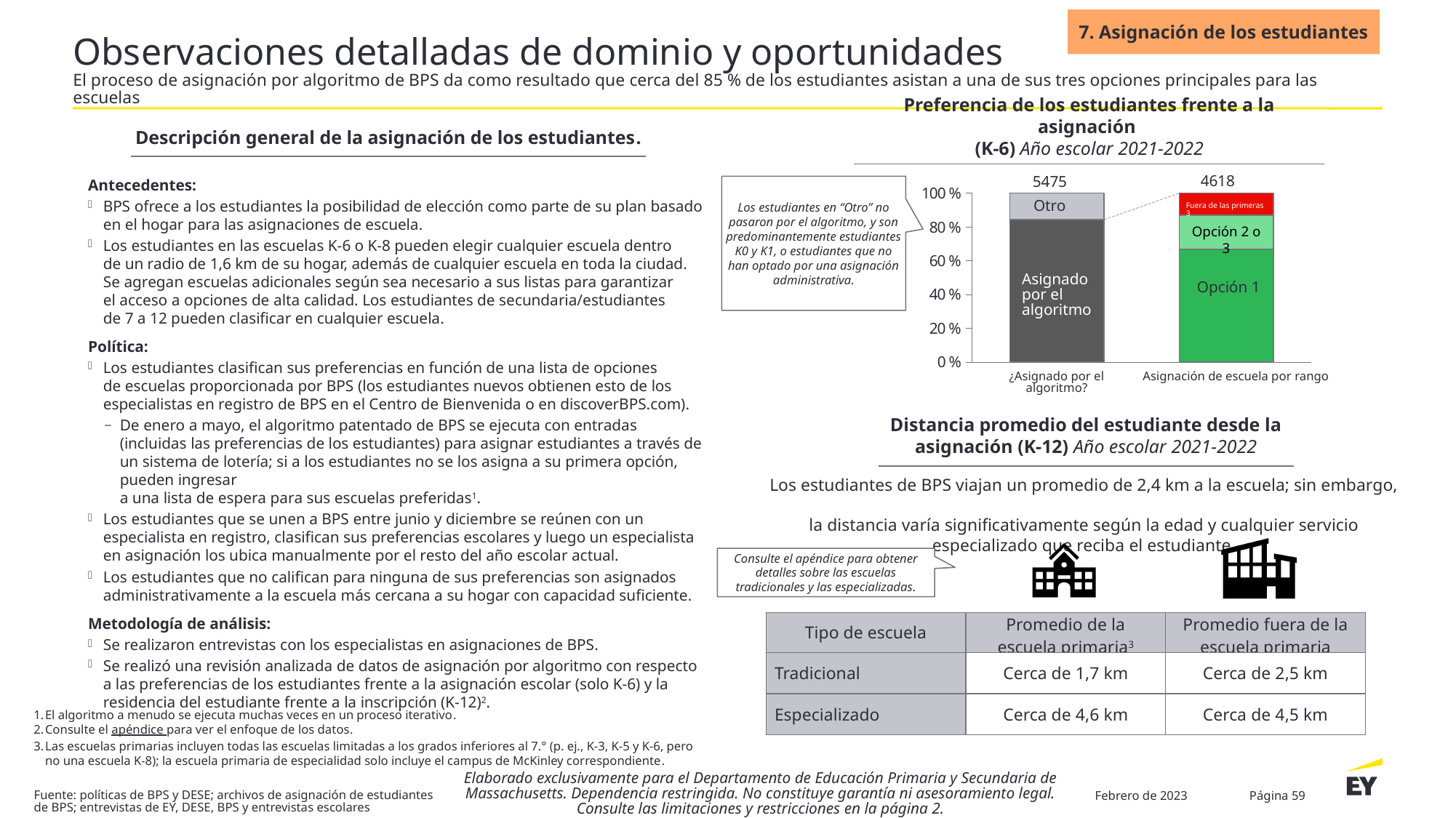
What total is printed above the 'Asignación de escuela por rango' bar? 4618 Is the share of the 'Opción 1' segment greater or less than 80 %? less How many segments make up the 'Asignación de escuela por rango' bar? 3 Is the share of the 'Asignado por el algoritmo' segment greater or less than 80 %? greater Which segment is the largest in the 'Asignación de escuela por rango' bar? Opción 1 What kind of chart is shown on the slide? bar chart Is the share of the 'Otro' segment greater or less than 20 %? less What is the difference between the totals printed above the two bars (5475 and 4618)? 857 Which bar has the larger printed total, '¿Asignado por el algoritmo?' or 'Asignación de escuela por rango'? ¿Asignado por el algoritmo? How many bars does the chart 'Preferencia de los estudiantes frente a la asignación' have? 2 What total is printed above the '¿Asignado por el algoritmo?' bar? 5475